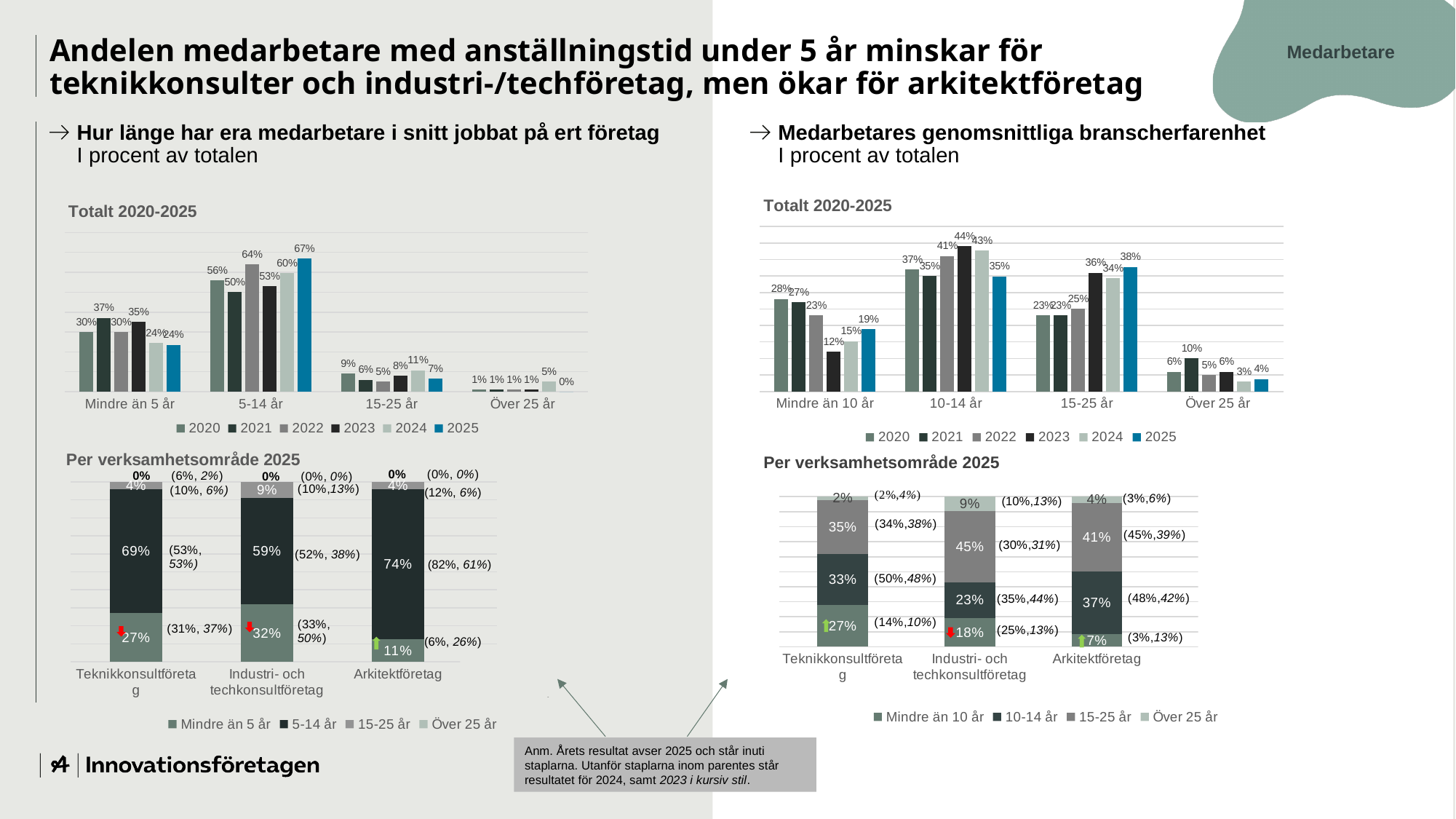
How many series does the legend of the top-left chart (Totalt 2020-2025, anställningstid) list? 6 In the top-right chart 'Medarbetares genomsnittliga branscherfarenhet' (Totalt 2020-2025), what is the value for 2023 in the '10-14 år' category? 44% In the bottom-right stacked chart 'Per verksamhetsområde 2025' (branscherfarenhet), what is the '15-25 år' share for Industri- och techkonsultföretag? 45% In the bottom-left stacked chart 'Per verksamhetsområde 2025' (anställningstid), what is the 2025 share of 'Mindre än 5 år' for Arkitektföretag? 11% In the top-right chart (Totalt 2020-2025, branscherfarenhet), which year has the lowest value in the 'Mindre än 10 år' category? 2023 In the top-left chart 'Hur länge har era medarbetare i snitt jobbat på ert företag' (Totalt 2020-2025), what is the value for 2025 in the '5-14 år' category? 67% In the bottom-left stacked chart 'Per verksamhetsområde 2025' (anställningstid), what is the total of the Teknikkonsultföretag bar (27%, 69%, 4%, 0%)? 100% What kind of chart is the bottom-right 'Per verksamhetsområde 2025' chart (branscherfarenhet)? Stacked bar chart In the top-right chart (Totalt 2020-2025, branscherfarenhet), is the 2025 value for '15-25 år' larger or smaller than the 2020 value? larger In the top-left chart (Totalt 2020-2025, anställningstid), which year has the highest value in the 'Mindre än 5 år' category? 2021 In the top-left chart (Totalt 2020-2025, anställningstid), what is the difference between the 2020 and 2025 values for 'Mindre än 5 år'? 6 percentage points In the bottom-left stacked chart 'Per verksamhetsområde 2025' (anställningstid), which company type has the largest '5-14 år' share? Arkitektföretag